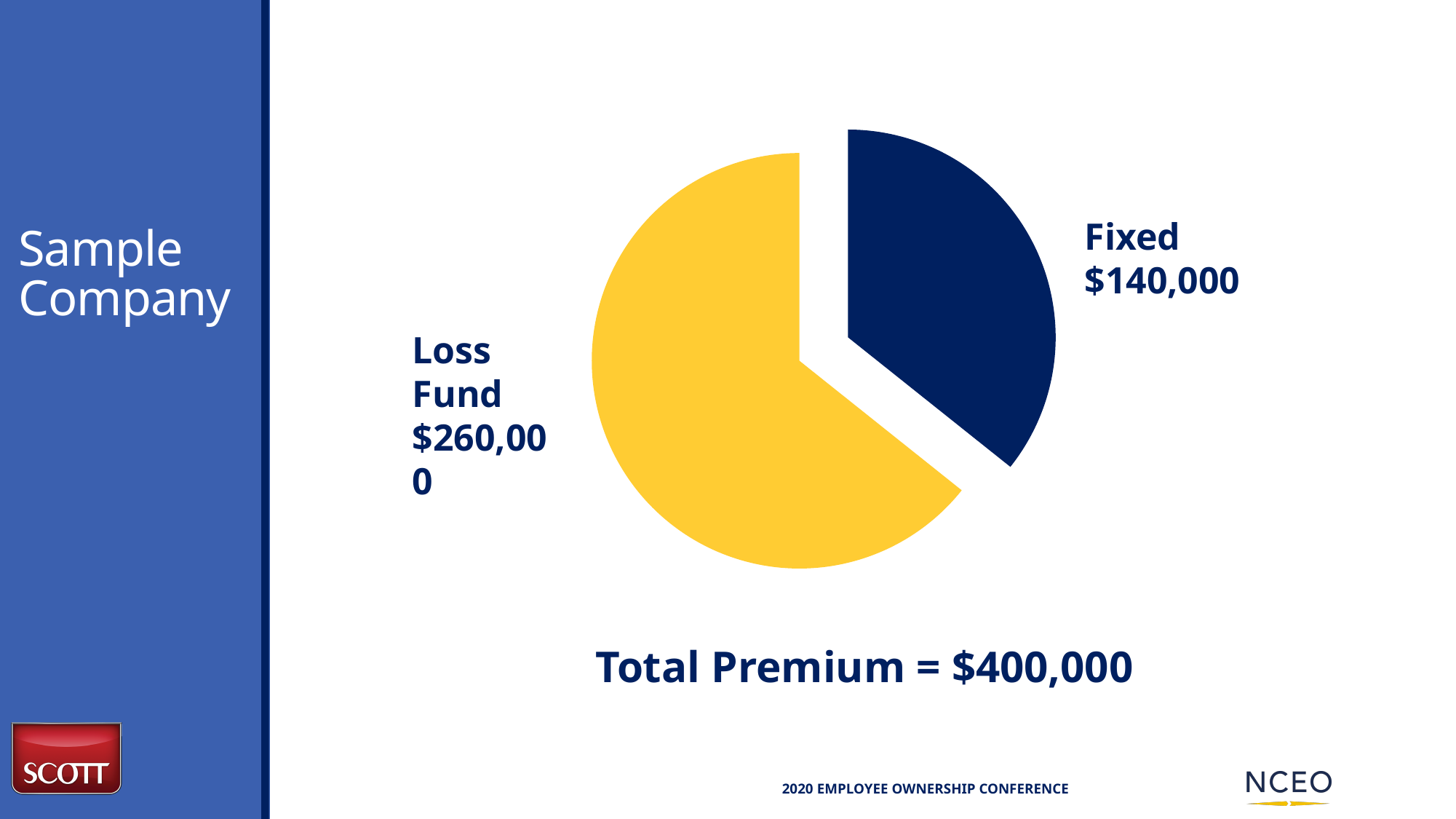
What share of the total premium is the Fixed slice? 35% What kind of chart is shown on the slide? pie chart What colour is the Fixed slice? dark blue Which is larger, Fixed or Loss Fund? Loss Fund What is the total premium shown below the chart? $400,000 What is the value of the Loss Fund slice? $260,000 What share of the total premium is the Loss Fund slice? 65% Which slice is the largest? Loss Fund How many slices does the pie chart have? 2 Which slice is the smallest? Fixed What is the value of the Fixed slice? $140,000 What is the difference between the Loss Fund and Fixed values? $120,000